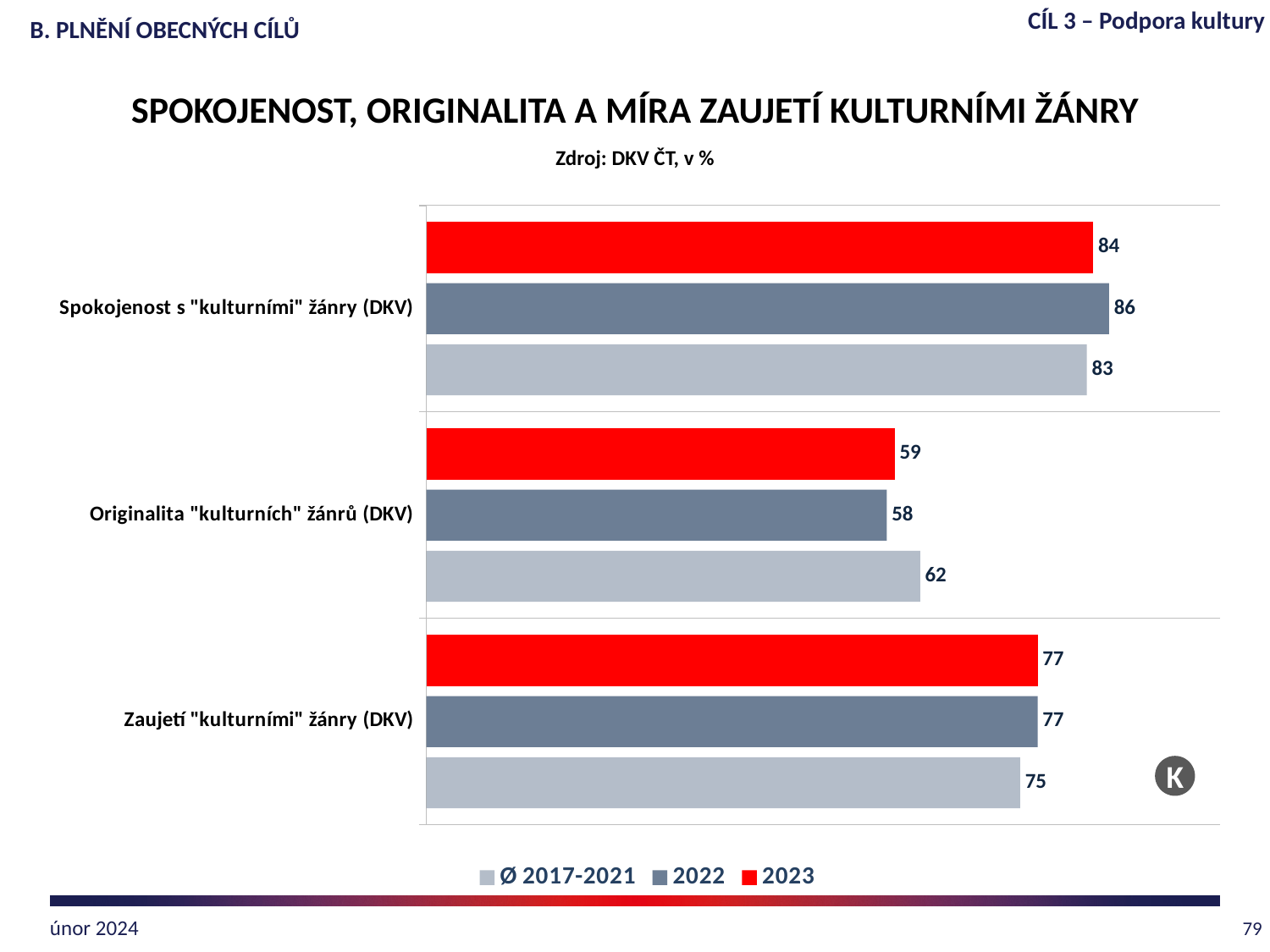
What is the difference between the Ø 2017-2021 and 2023 values for Zaujetí "kulturními" žánry (DKV)? 2 What is the Ø 2017-2021 value for Zaujetí "kulturními" žánry (DKV)? 75 Which category has the lowest Ø 2017-2021 value? Originalita "kulturních" žánrů (DKV) Which category has the highest 2023 value? Spokojenost s "kulturními" žánry (DKV) For Originalita "kulturních" žánrů (DKV), which is larger: the Ø 2017-2021 value or the 2023 value? Ø 2017-2021 What is the difference between the 2022 and 2023 values for Spokojenost s "kulturními" žánry (DKV)? 2 How many series does the legend list? 3 How many categories are shown on the chart? 3 What is the 2023 value for Spokojenost s "kulturními" žánry (DKV)? 84 What is the 2022 value for Originalita "kulturních" žánrů (DKV)? 58 What kind of chart is shown on the slide? bar chart Which colour represents the 2023 series in the legend? red